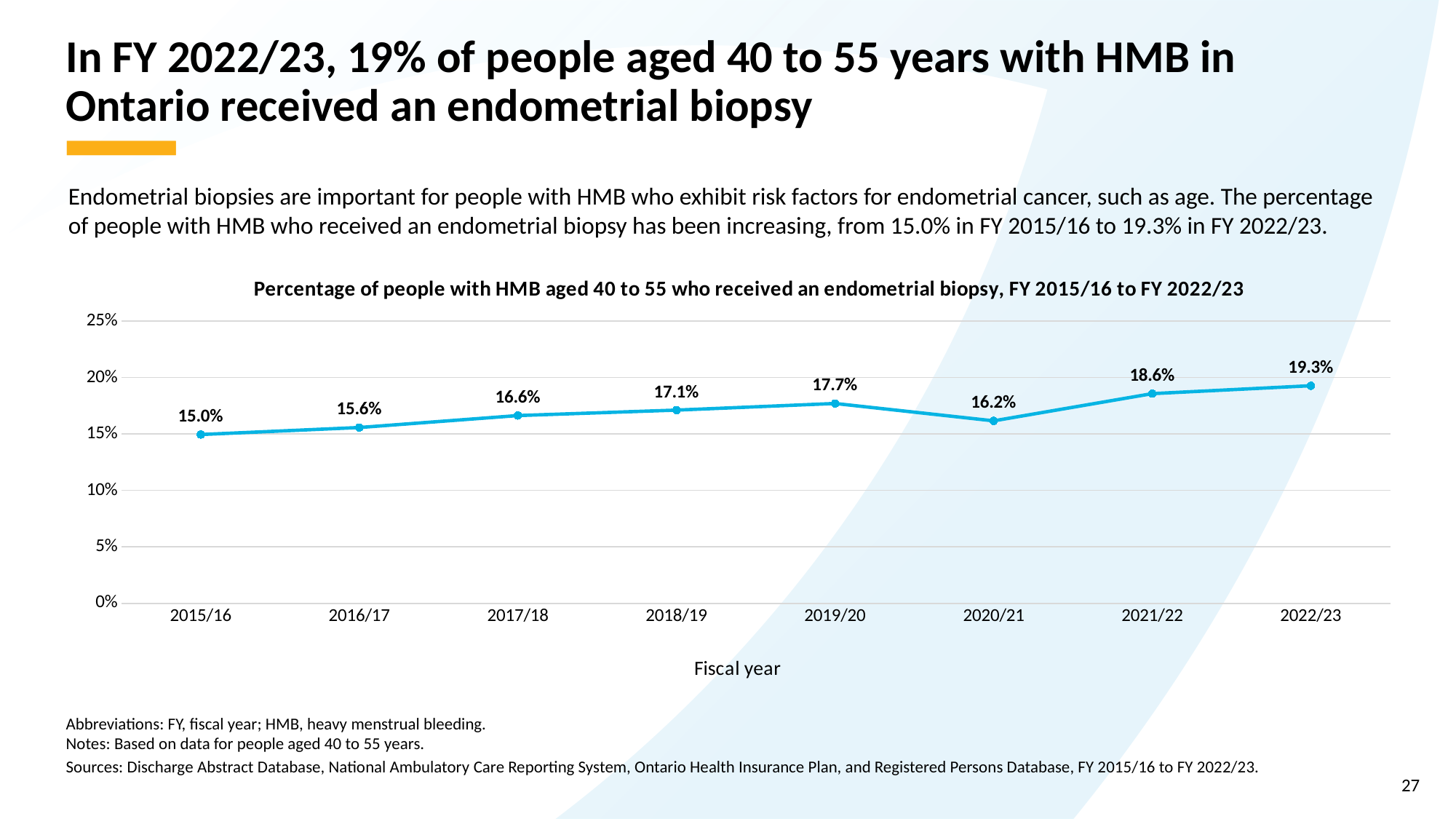
Which is larger, the value for 2018/19 or the value for 2020/21? 2018/19 Which fiscal year has the highest percentage? 2022/23 What is the label of the x axis? Fiscal year Which fiscal year has the lowest percentage? 2015/16 What is the value shown for 2017/18? 16.6% Is the value for 2021/22 greater or less than 20%? less What is the difference in percentage points between 2022/23 and 2015/16? 4.3 percentage points What percentage of people with HMB aged 40 to 55 received an endometrial biopsy in FY 2019/20? 17.7% What is the value shown for 2020/21? 16.2% How many fiscal years are plotted on the chart? 8 What is the difference between the values for 2019/20 and 2020/21? 1.5 percentage points What kind of chart is shown on the slide? Line chart